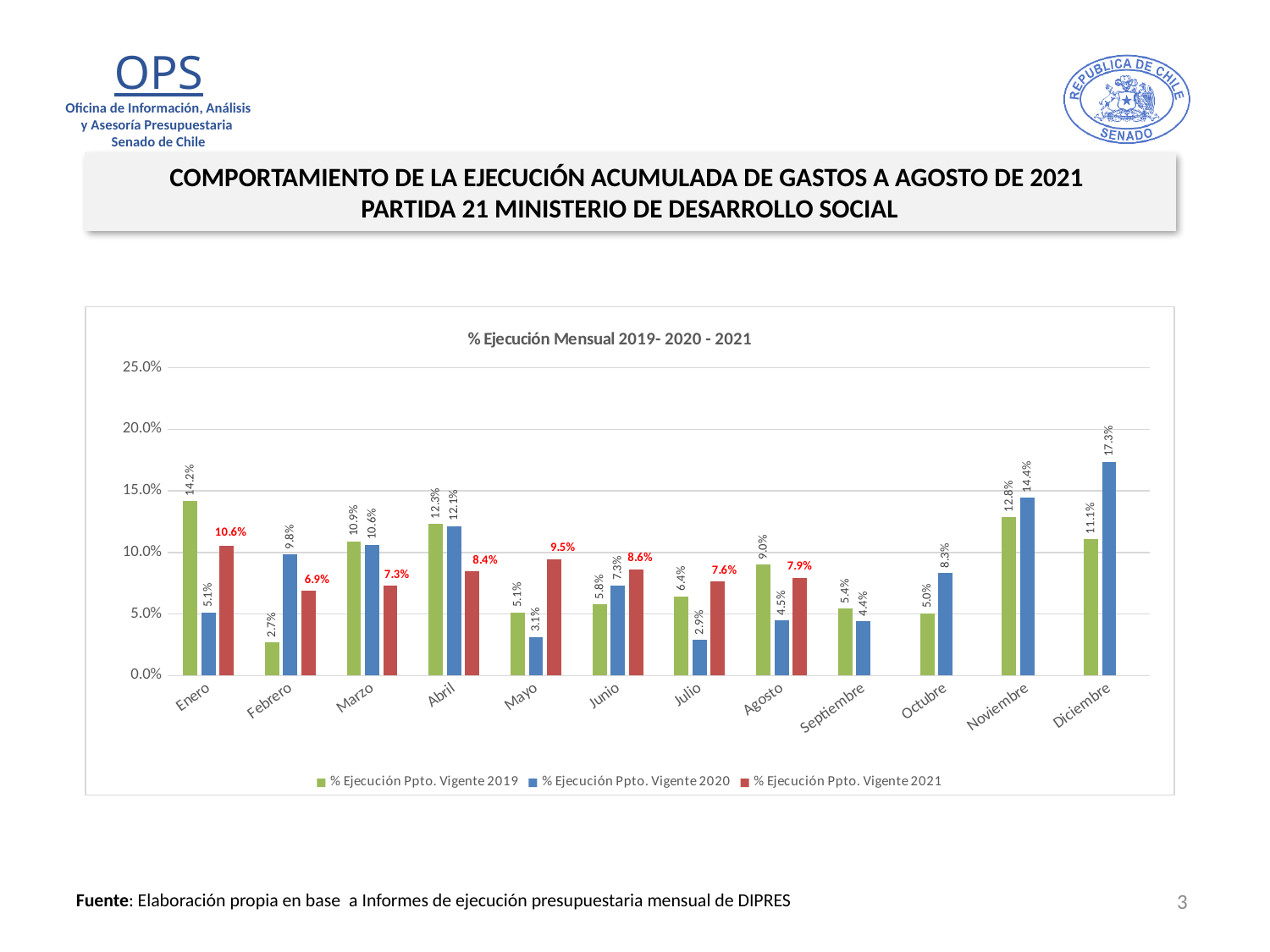
What type of chart is shown on the slide? Bar chart What is the value of % Ejecución Ppto. Vigente 2021 for Enero? 10.6% What is the value of % Ejecución Ppto. Vigente 2020 for Diciembre? 17.3% What is the difference between the 2019 and 2020 values for Enero? 9.1% How many months are shown on the x axis? 12 What is the title of the chart? % Ejecución Mensual 2019- 2020 - 2021 Which month has the lowest value for % Ejecución Ppto. Vigente 2020? Julio Is the value of % Ejecución Ppto. Vigente 2020 for Noviembre greater or less than 10.0%? greater Which is larger for Mayo: the 2019 value or the 2021 value? The 2021 value What is the value of % Ejecución Ppto. Vigente 2019 for Agosto? 9.0% Which month has the highest value for % Ejecución Ppto. Vigente 2019? Enero How many series does the legend list? 3